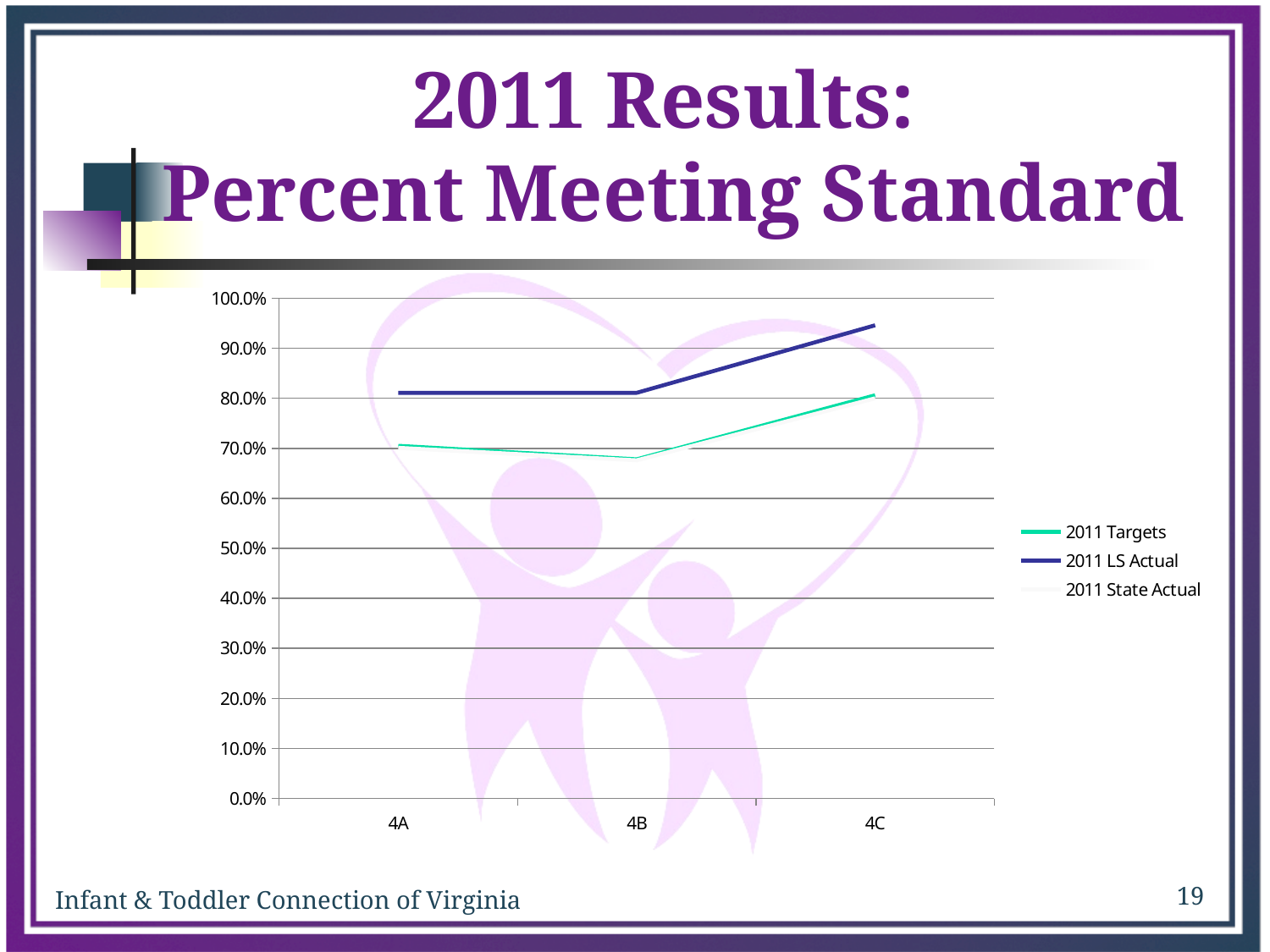
What kind of chart is shown on the slide? line chart Is the value for 2011 LS Actual at 4A greater or less than 90.0%? less Does the 2011 LS Actual line rise or fall from 4B to 4C? rise Is the value for 2011 Targets at 4A greater or less than 60.0%? greater What are the series names listed in the chart's legend? 2011 Targets, 2011 LS Actual, 2011 State Actual Is the value for 2011 LS Actual at 4C greater or less than 90.0%? greater For the 2011 Targets series, which category has the lowest value? 4B How many categories are shown on the x axis of the chart? 3 At 4C, which series has the larger value, 2011 Targets or 2011 LS Actual? 2011 LS Actual For the 2011 LS Actual series, which category has the highest value? 4C How many series does the chart's legend list? 3